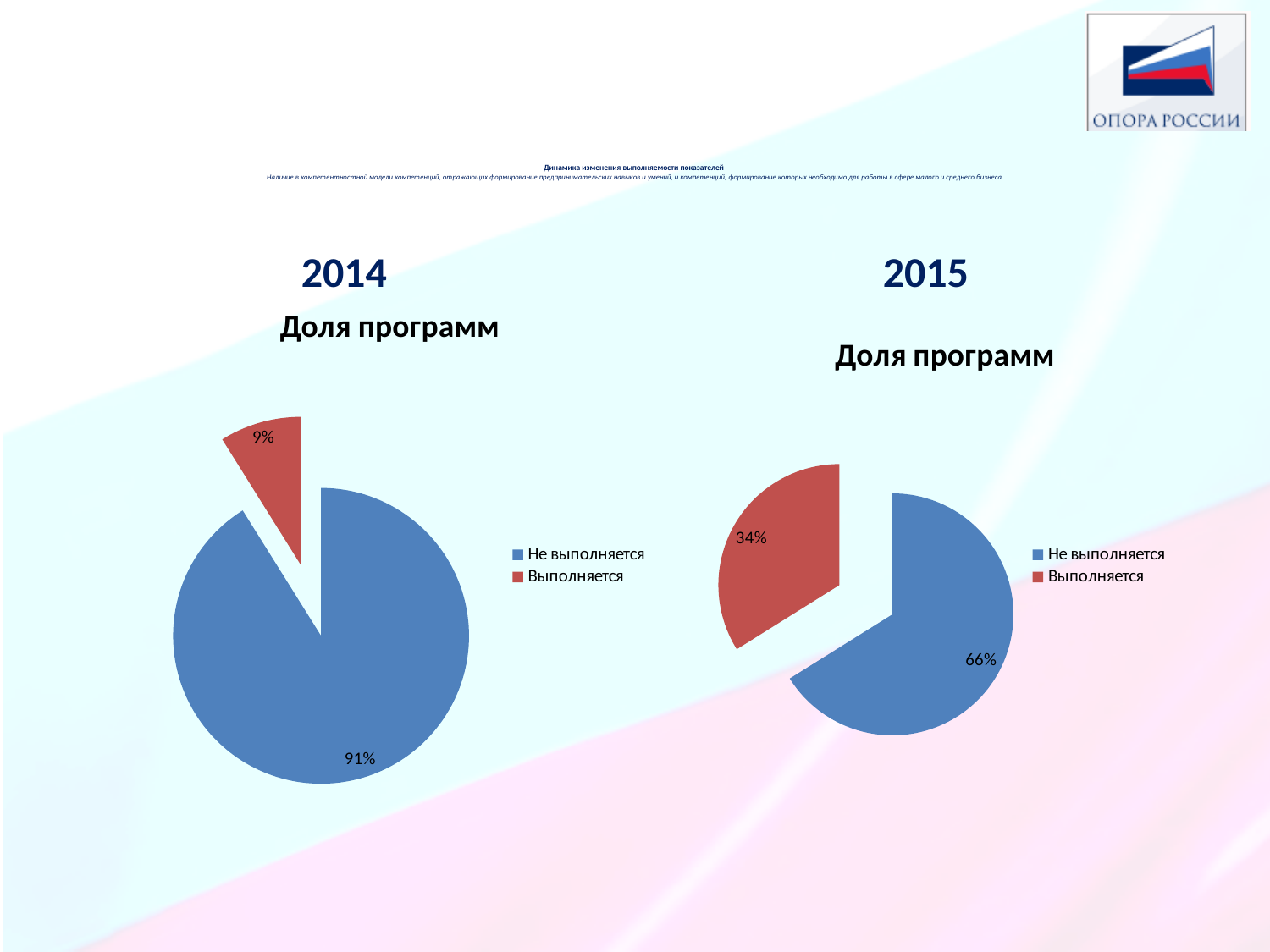
In the 2015 chart, what share of programs is labelled 'Не выполняется'? 66% In the 2014 chart, what share of programs is labelled 'Выполняется'? 9% In the 2015 chart, which colour represents 'Выполняется'? Red What kind of chart is used for the 2014 'Доля программ' data? Pie chart How many slices does the 2015 pie chart have? 2 In the 2014 chart, which category has the smallest slice? Выполняется How many entries does the legend of the 2014 chart list? 2 In the 2015 chart, which category has the largest slice? Не выполняется In the 2014 chart, what is the difference in percentage points between 'Не выполняется' and 'Выполняется'? 82 In the 2014 chart, what share of programs is labelled 'Не выполняется'? 91% In the 2015 chart, what share of programs is labelled 'Выполняется'? 34% Which is larger: the 'Выполняется' share in 2014 or in 2015? 2015